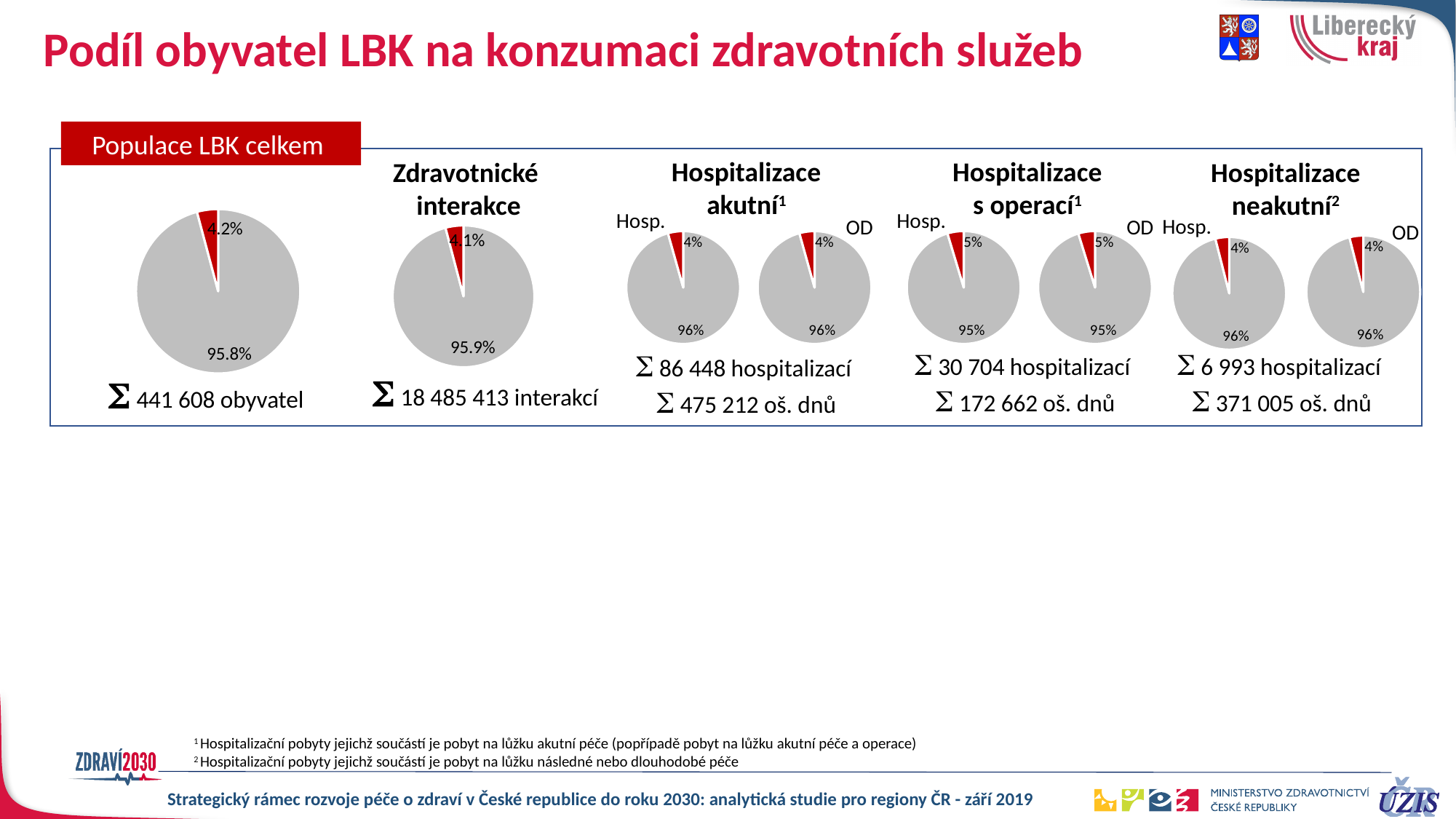
Which has a larger red slice share: the "Hospitalizace s operací" Hosp. pie chart or the "Hospitalizace akutní" Hosp. pie chart? Hospitalizace s operací In the "Zdravotnické interakce" pie chart, what share is shown for the grey slice? 95.9% In the "Populace LBK celkem" pie chart, what share is shown for the grey slice? 95.8% In the "Hospitalizace akutní" OD pie chart, what share is shown for the grey slice? 96% What total number of hospitalizations is printed under the "Hospitalizace akutní" pie charts? 86 448 hospitalizací In the "Hospitalizace s operací" Hosp. pie chart, what share is shown for the red slice? 5% In the "Populace LBK celkem" pie chart, what share is shown for the red slice? 4.2% How many pie charts are shown on the slide? 8 In the "Zdravotnické interakce" pie chart, what share is shown for the red slice? 4.1% What kind of chart is used for "Populace LBK celkem"? pie chart In the "Hospitalizace neakutní" Hosp. pie chart, what share is shown for the red slice? 4% What is the difference between the red slice share in the "Populace LBK celkem" pie chart and the red slice share in the "Zdravotnické interakce" pie chart? 0.1%